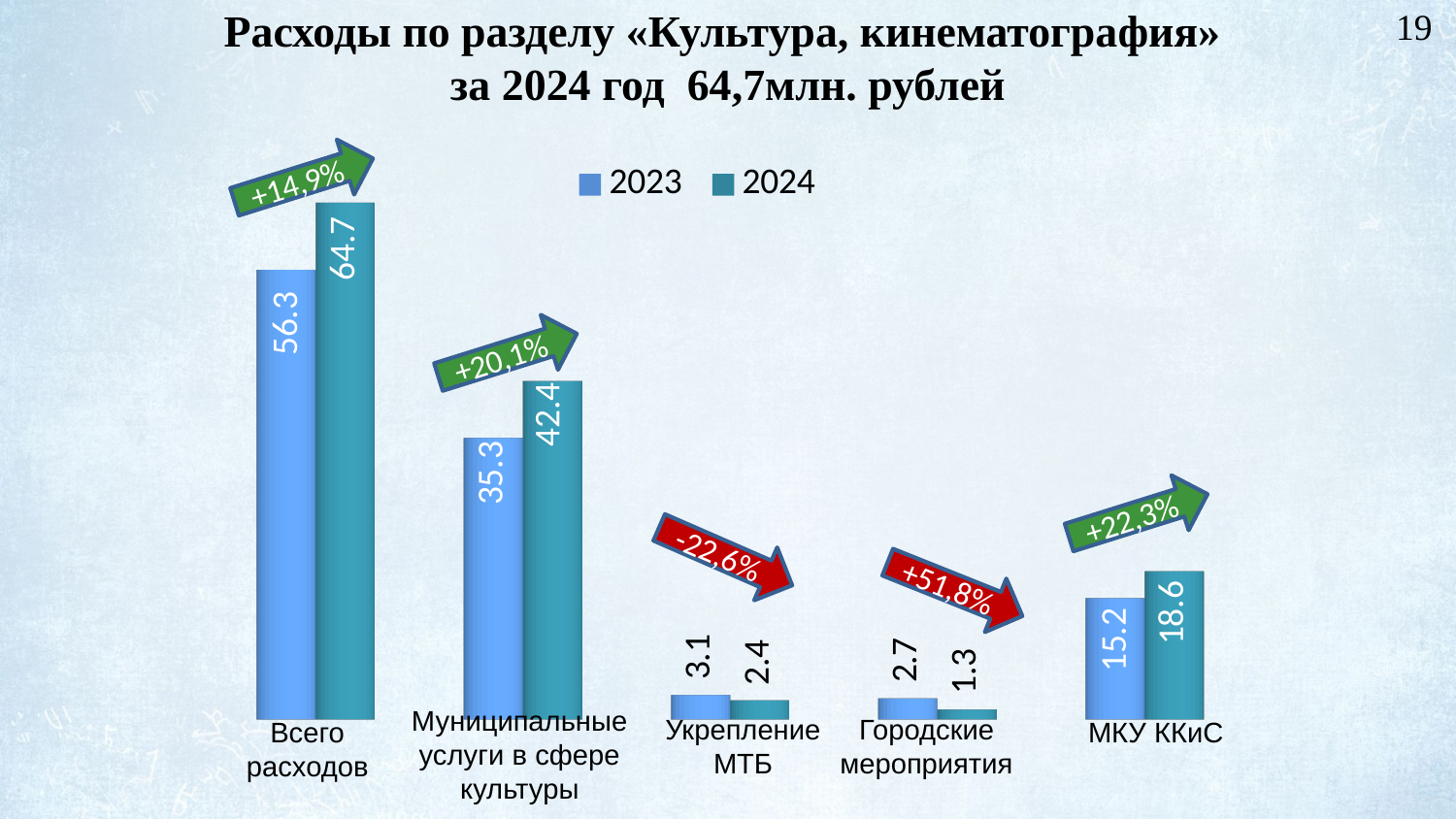
Which category has the lowest 2024 value? Городские мероприятия What is the 2023 value for «МКУ ККиС»? 15.2 What is the 2023 value for «Муниципальные услуги в сфере культуры»? 35.3 How many series does the legend list? 2 What is the 2024 value for «Всего расходов»? 64.7 What kind of chart is shown on the slide? Bar chart What is the difference between the 2024 and 2023 values for «Всего расходов»? 8.4 What is the 2024 value for «Укрепление МТБ»? 2.4 How many categories are shown on the x axis? 5 What percentage change is shown in the arrow above «МКУ ККиС»? +22,3% Which is larger for «Укрепление МТБ»: the 2023 value or the 2024 value? 2023 Which category has the highest 2023 value? Всего расходов